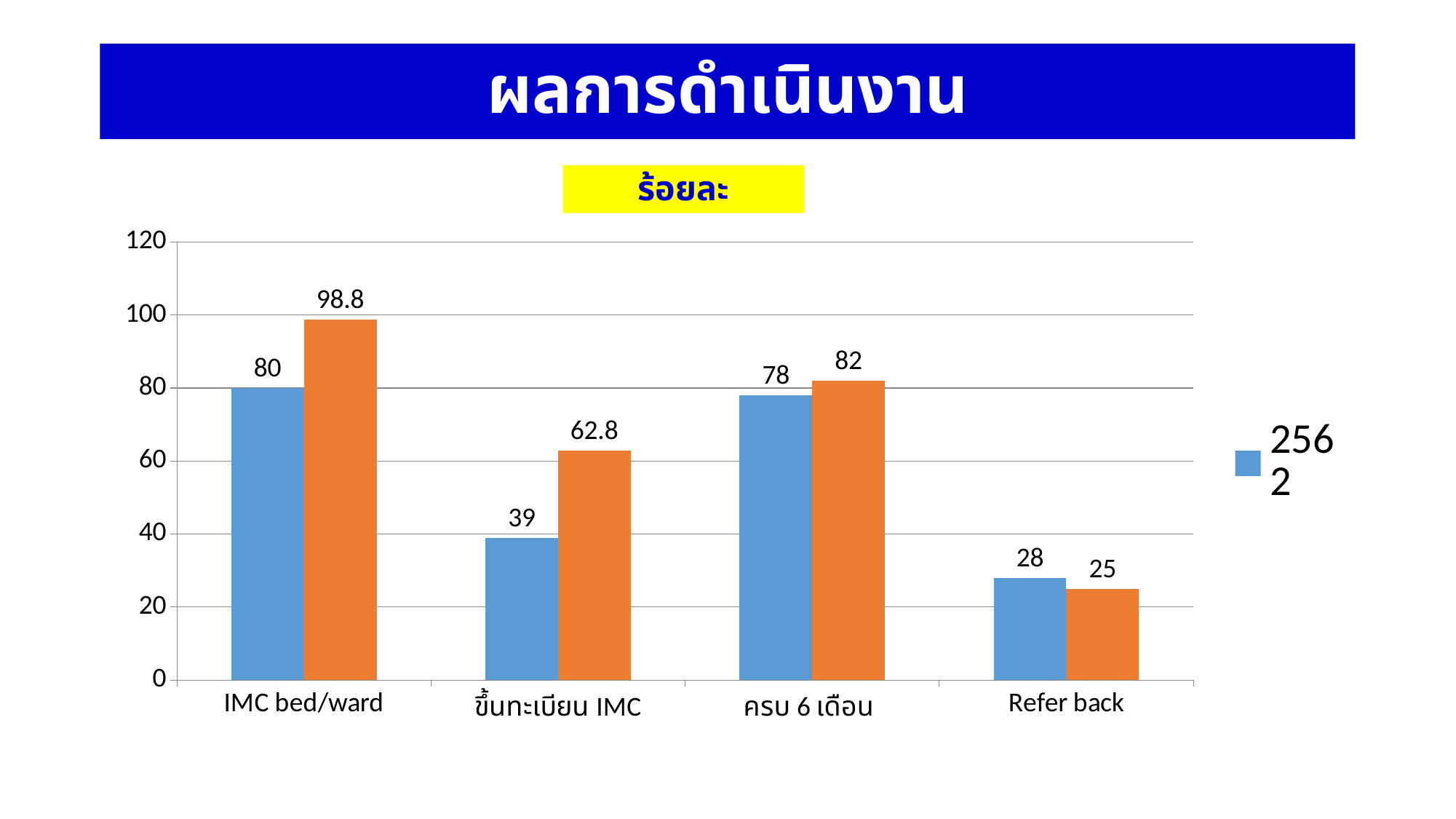
What is the value of the 2562 (blue) series for IMC bed/ward? 80 Which category has the highest value in the 2562 (blue) series? IMC bed/ward What is the value of the orange series for ขึ้นทะเบียน IMC? 62.8 What is the difference between the orange and blue (2562) values for IMC bed/ward? 18.8 Which category has the lowest value in the orange series? Refer back What is the value of the orange series for Refer back? 25 What is the value of the 2562 (blue) series for ขึ้นทะเบียน IMC? 39 How many categories are shown on the x axis of the chart? 4 What is the value of the orange series for IMC bed/ward? 98.8 For Refer back, which series has the larger value, the blue (2562) series or the orange series? The blue (2562) series What kind of chart is shown on the slide? Bar chart What is the difference between the orange and blue (2562) values for ขึ้นทะเบียน IMC? 23.8